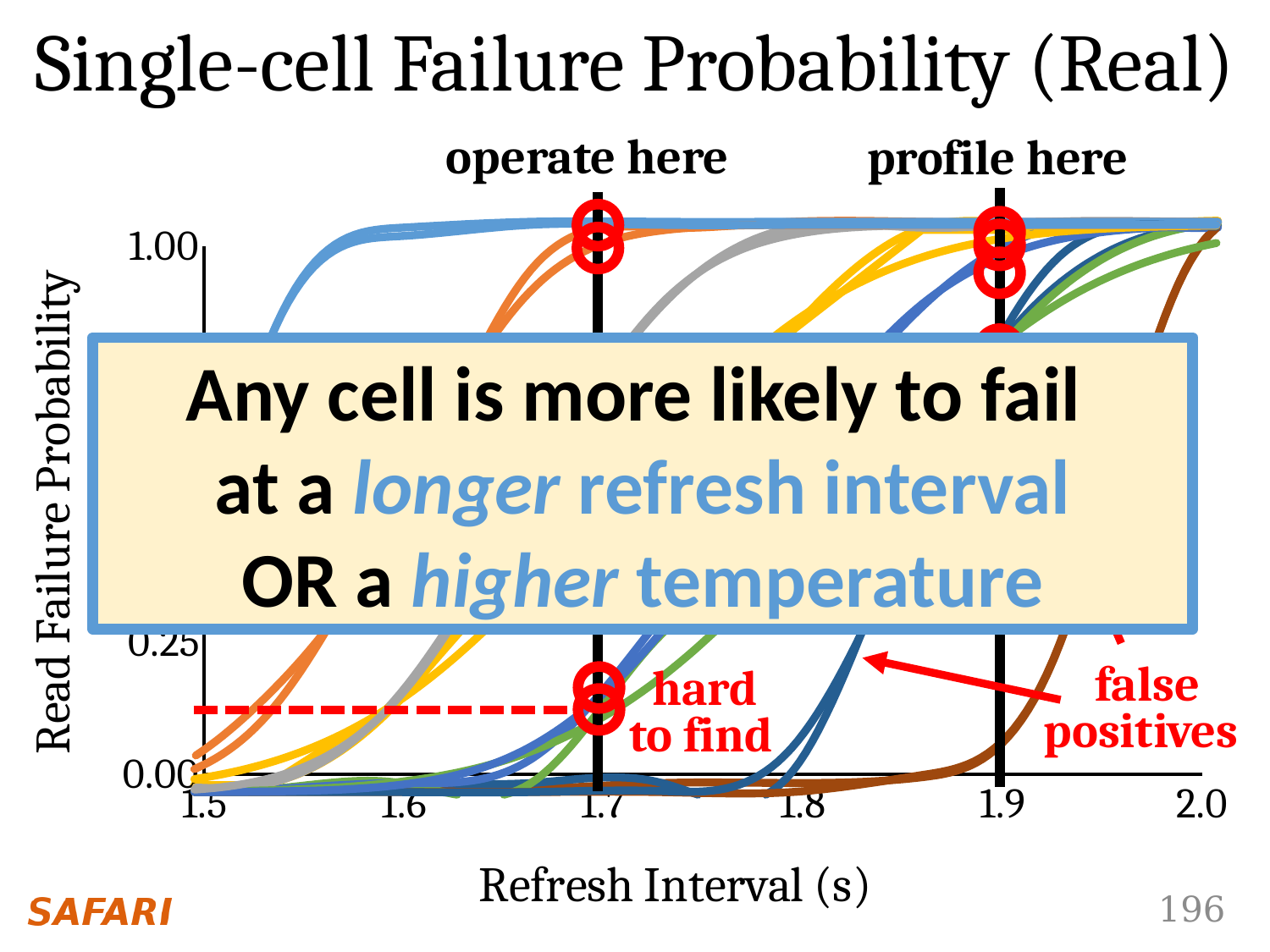
Is the value of the light blue curve at a refresh interval of 1.7 s greater or less than 0.25? greater What kind of chart is shown on the slide? line chart At which refresh interval is the 'profile here' vertical line placed? 1.9 Is the value of the brown curve at a refresh interval of 1.7 s greater or less than 0.25? less What is the label of the x axis? Refresh Interval (s) Do the curves rise or fall as the refresh interval increases along the x axis? rise At which refresh interval is the 'operate here' vertical line placed? 1.7 What is the title of the chart? Single-cell Failure Probability (Real)